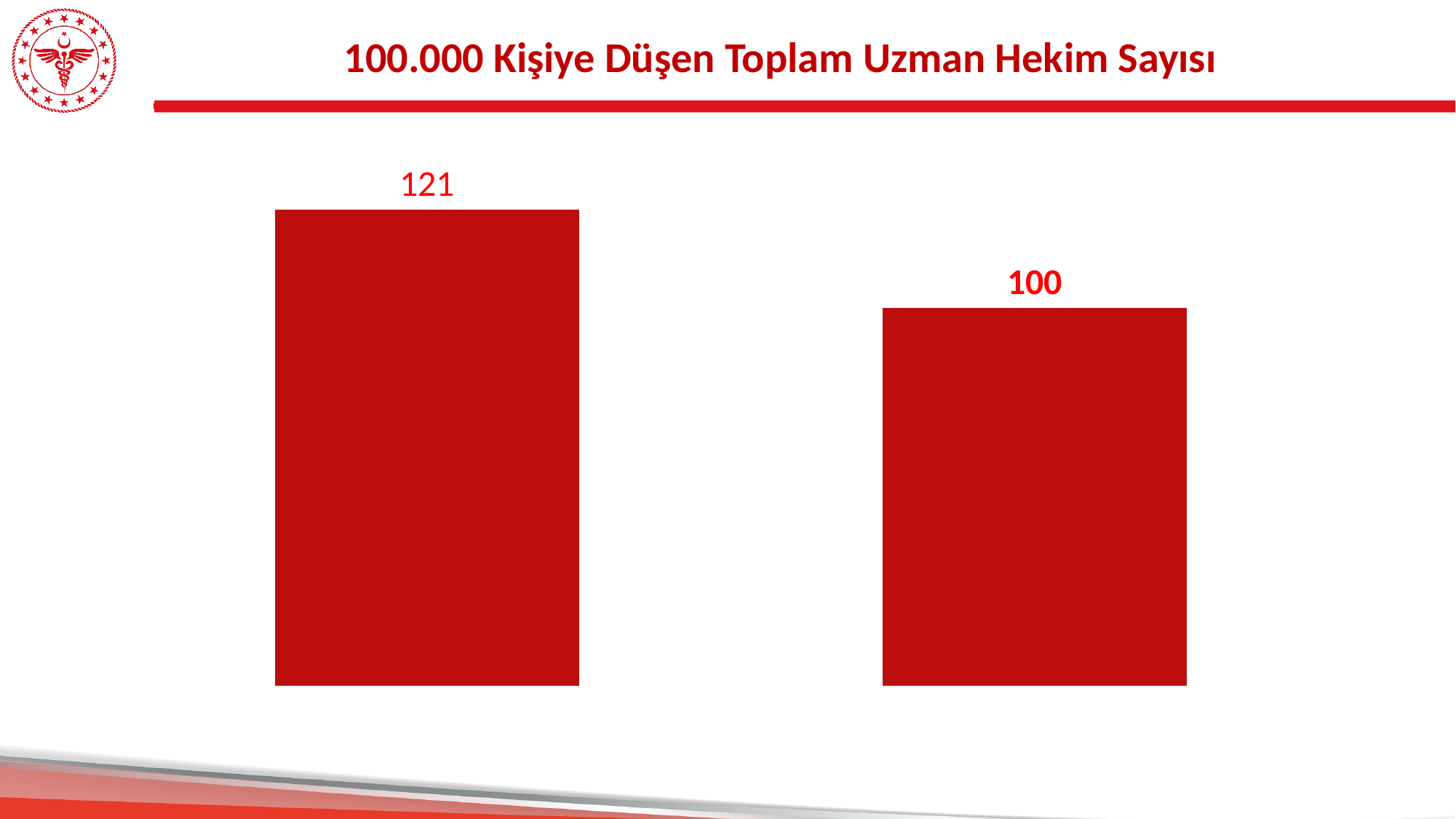
How many bars are plotted in the chart? 2 What is the value shown on the right bar of the chart? 100 What is the title of the slide's chart? 100.000 Kişiye Düşen Toplam Uzman Hekim Sayısı Which bar has the lower value, the left or the right? right What is the difference between the left bar's value and the right bar's value? 21 What is the value shown on the left bar of the chart? 121 What colour are the bars in the chart? red Which bar has the higher value, the left or the right? left What kind of chart is shown on the slide? bar chart Do the values fall or rise from the left bar to the right bar? fall Is the left bar's value larger or smaller than the right bar's value? larger